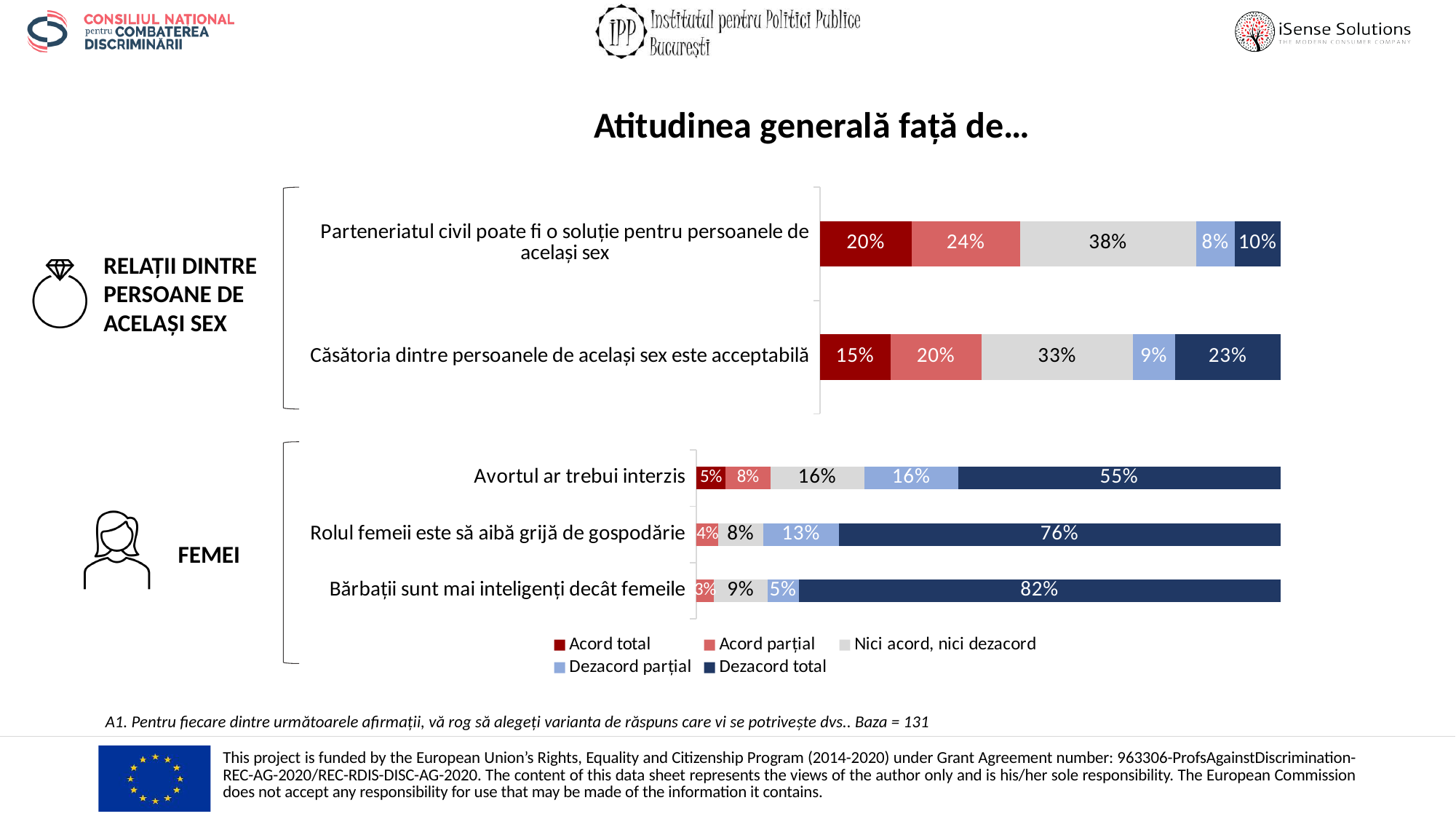
In the top chart (Relații dintre persoane de același sex), how many percentage points higher is 'Dezacord total' for 'Căsătoria dintre persoanele de același sex este acceptabilă' than for 'Parteneriatul civil poate fi o soluție pentru persoanele de același sex'? 13 percentage points In the bottom chart (Femei), what is the 'Dezacord total' value for 'Rolul femeii este să aibă grijă de gospodărie'? 76% In the bottom chart (Femei), which statement has the highest 'Dezacord total' share? Bărbații sunt mai inteligenți decât femeile In the top chart (Relații dintre persoane de același sex), what percentage chose 'Nici acord, nici dezacord' for 'Parteneriatul civil poate fi o soluție pentru persoanele de același sex'? 38% In the bottom chart (Femei), which statement has the larger 'Dezacord total' share: 'Avortul ar trebui interzis' or 'Rolul femeii este să aibă grijă de gospodărie'? Rolul femeii este să aibă grijă de gospodărie How many response categories does the legend list? 5 How many statements are shown in the bottom chart (Femei)? 3 In the bottom chart (Femei), what is the 'Dezacord total' value for 'Bărbații sunt mai inteligenți decât femeile'? 82% In the top chart (Relații dintre persoane de același sex), what is the 'Dezacord total' value for 'Căsătoria dintre persoanele de același sex este acceptabilă'? 23% What type of chart is used on this slide? Stacked bar chart In the top chart (Relații dintre persoane de același sex), what is the 'Acord total' value for 'Parteneriatul civil poate fi o soluție pentru persoanele de același sex'? 20% In the bottom chart (Femei), what is the 'Dezacord parțial' value for 'Avortul ar trebui interzis'? 16%